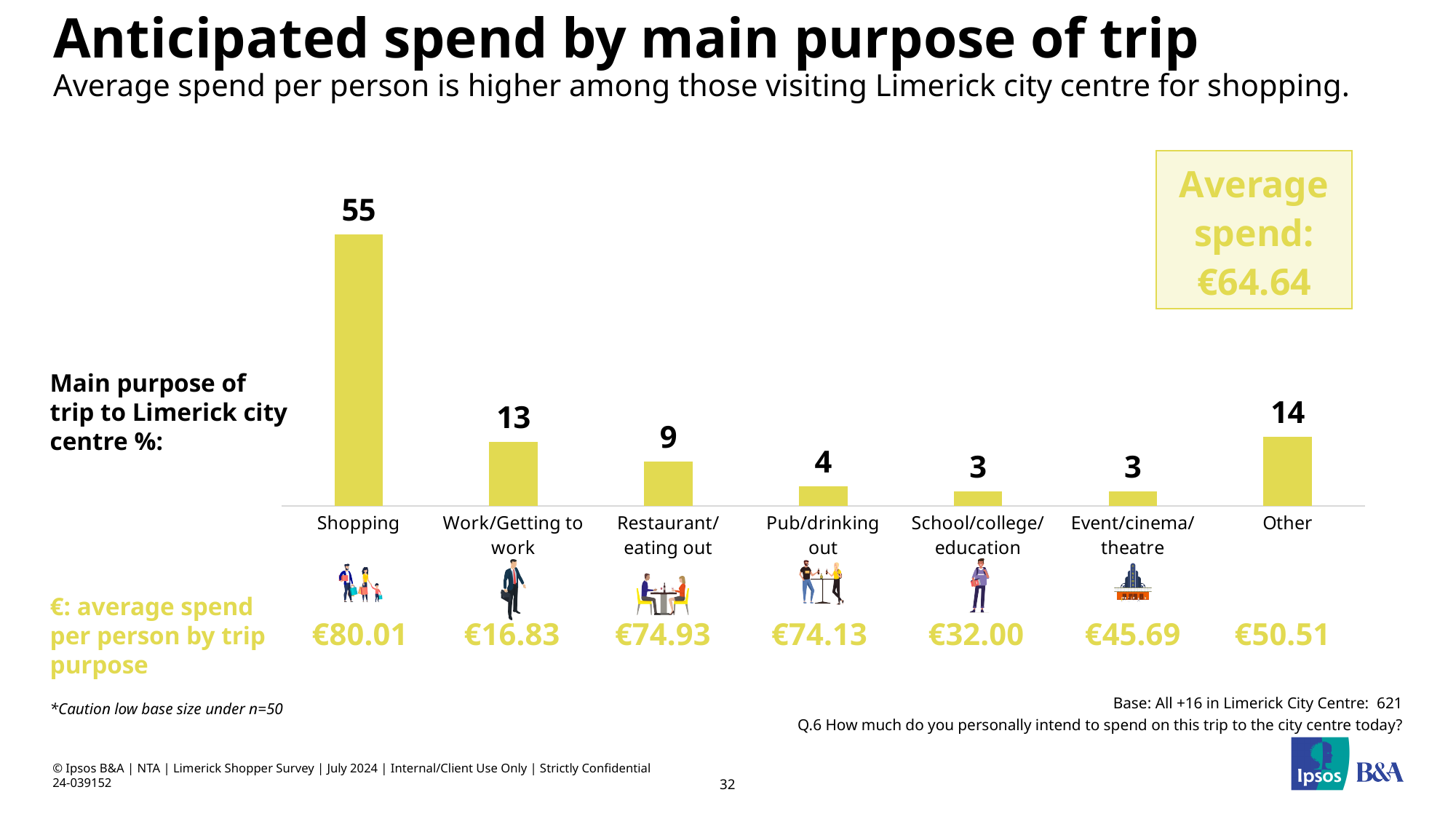
What is the average spend per person for those visiting for Restaurant/eating out? €74.93 What is the difference in percentage points between Shopping and Other as main purpose of trip? 41 What percentage of respondents gave Work/Getting to work as the main purpose of their trip? 13 What is the base size stated on the slide? 621 Which main purpose of trip has the highest percentage of respondents? Shopping What is the overall average spend shown in the box on the slide? €64.64 What type of chart is used to show the main purpose of trip percentages? Bar chart What percentage of respondents gave Shopping as the main purpose of their trip to Limerick city centre? 55 How many trip purpose categories are shown in the chart? 7 Which trip purpose has the lowest average spend per person? Work/Getting to work What is the average spend per person for those visiting for Work/Getting to work? €16.83 Which has a higher average spend per person: Pub/drinking out or School/college/education? Pub/drinking out